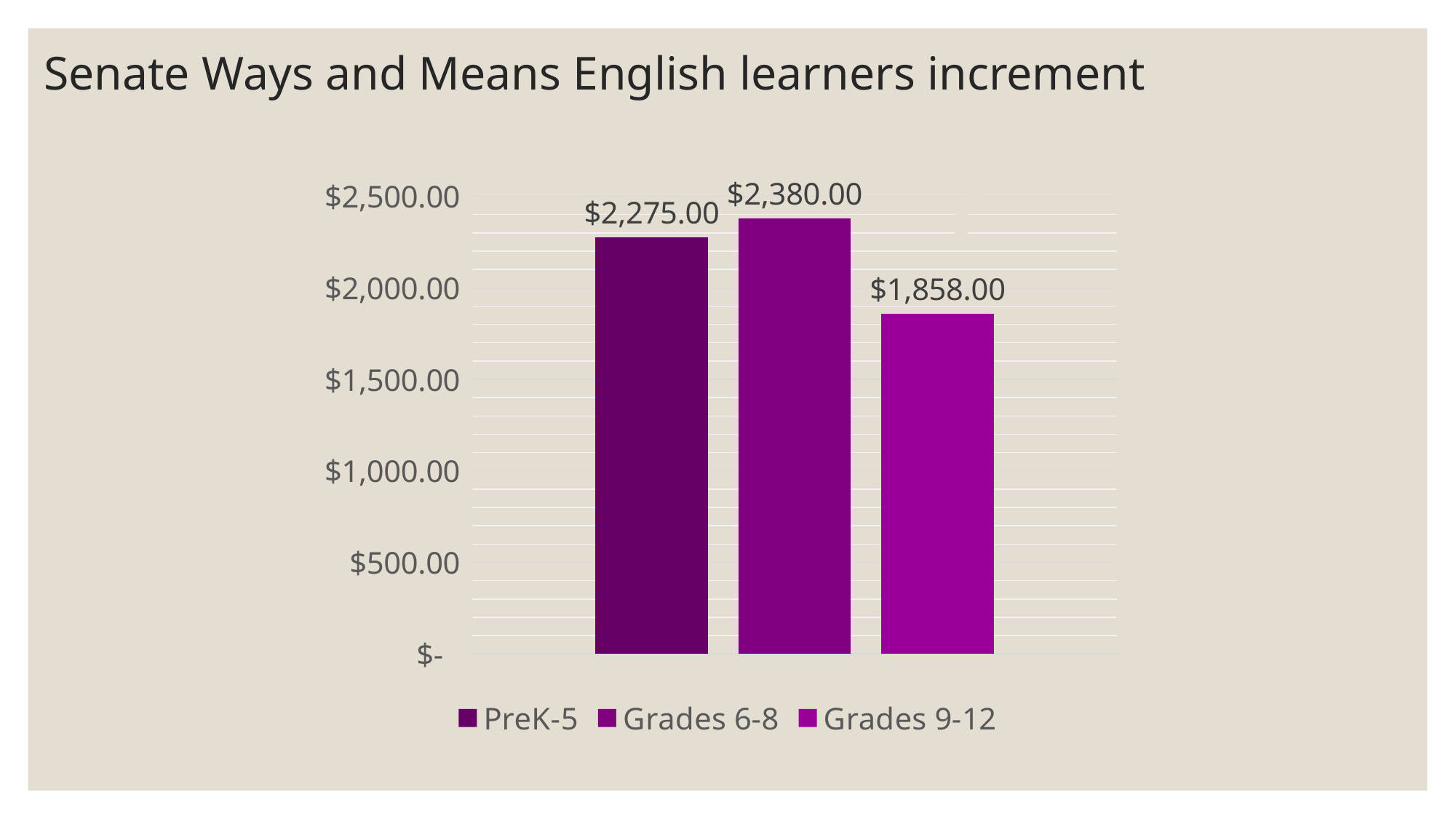
What is the value for Grades 9-12? $1,858.00 What kind of chart is shown on the slide? bar chart Which grade band has the lowest value? Grades 9-12 What is the value for PreK-5? $2,275.00 What is the difference between the values for PreK-5 and Grades 9-12? $417.00 Is the value for Grades 9-12 greater or less than $2,000.00? less What is the difference between the values for Grades 6-8 and PreK-5? $105.00 Which grade band has the highest value? Grades 6-8 What is the title of the chart? Senate Ways and Means English learners increment How many bars are shown in the chart? 3 What is the value for Grades 6-8? $2,380.00 Which is larger, the value for PreK-5 or the value for Grades 9-12? PreK-5